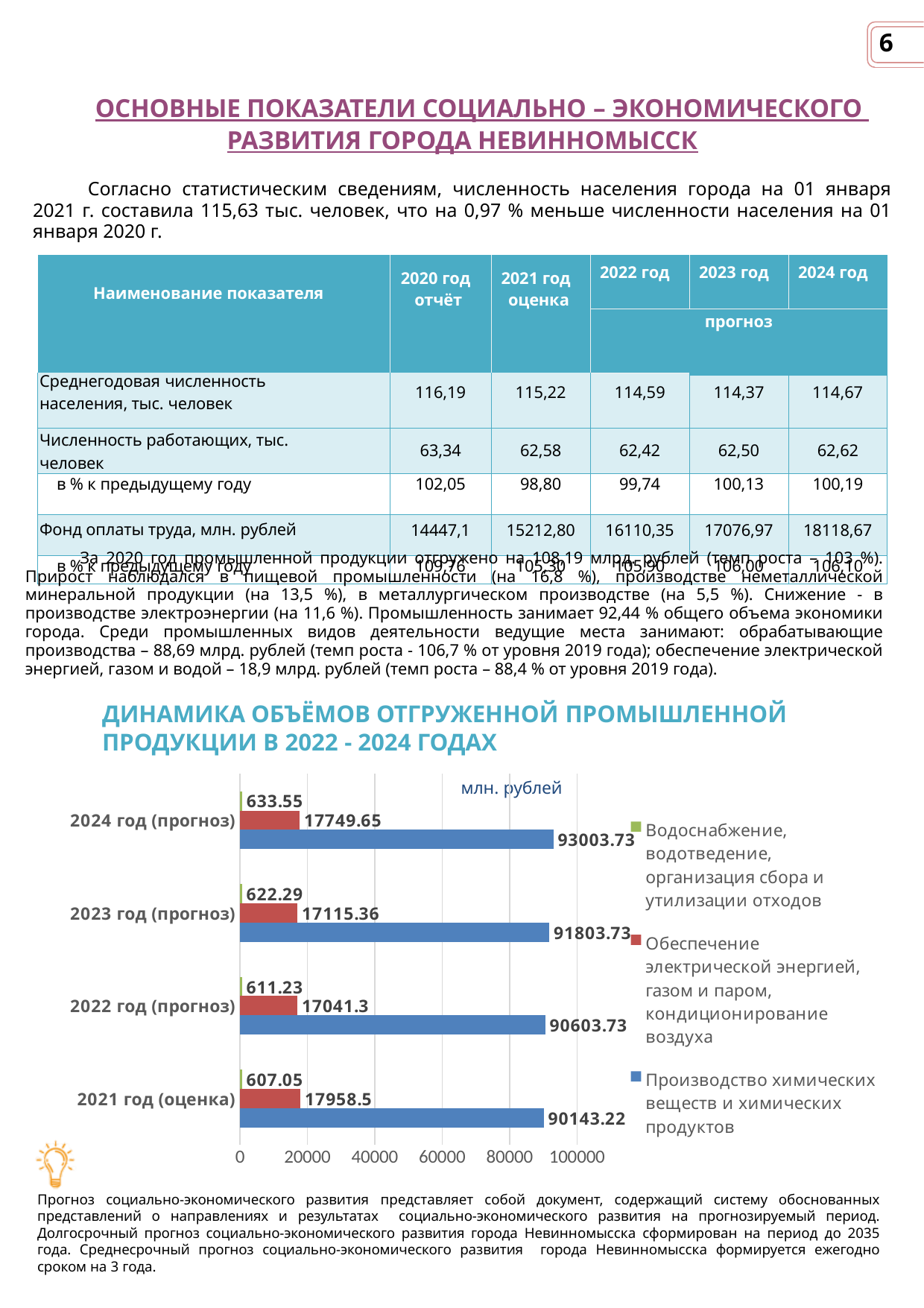
What unit is indicated on the chart? млн. рублей How many year categories are shown on the chart? 4 What is the value for Обеспечение электрической энергией, газом и паром, кондиционирование воздуха in 2021 год (оценка)? 17958.5 What is the value for Водоснабжение, водоотведение, организация сбора и утилизации отходов in 2022 год (прогноз)? 611.23 What is the difference between the Производство химических веществ values for 2024 год (прогноз) and 2021 год (оценка)? 2860.51 In which year is the value for Производство химических веществ и химических продуктов the highest? 2024 год (прогноз) In which year is the value for Обеспечение электрической энергией, газом и паром, кондиционирование воздуха the lowest? 2022 год (прогноз) Which is larger: the Обеспечение электрической энергией value for 2021 год (оценка) or for 2023 год (прогноз)? 2021 год (оценка) What is the value for Производство химических веществ и химических продуктов in 2024 год (прогноз)? 93003.73 How many series does the chart legend list? 3 What type of chart is shown on the slide? bar chart Does the value for Водоснабжение, водоотведение, организация сбора и утилизации отходов rise or fall from 2021 to 2024? rise